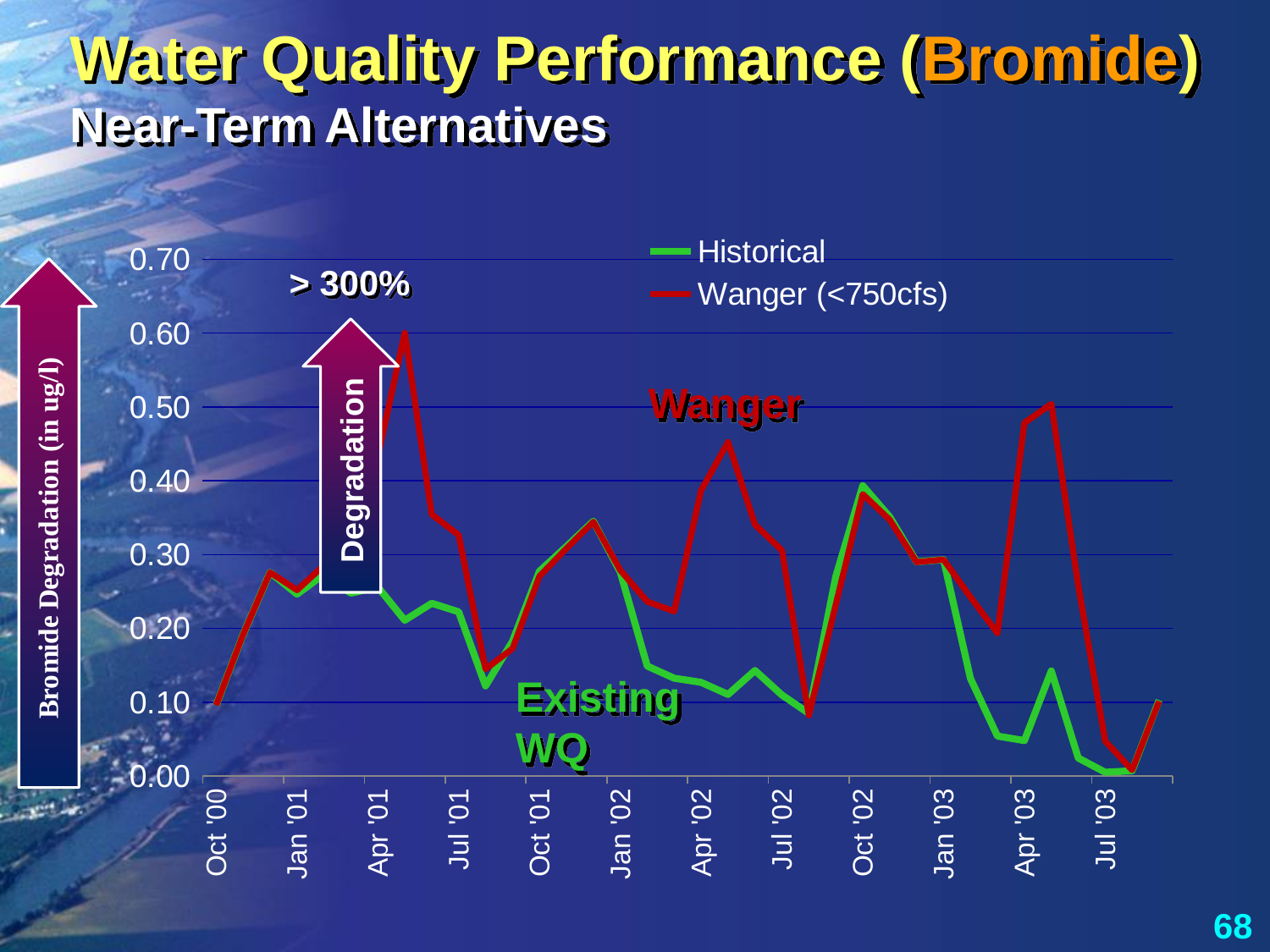
How many labelled tick marks are on the x axis? 12 Is the peak value of the Wanger (<750cfs) series around Apr '01 greater or less than 0.50? greater Does the Historical series rise or fall between Oct '02 and Jul '03? fall Which series reaches the highest value on the chart? Wanger (<750cfs) At Apr '02, which series has the larger value, Historical or Wanger (<750cfs)? Wanger (<750cfs) Does the Wanger (<750cfs) series rise or fall between Oct '00 and Apr '01? rise Is the Historical value at Jul '03 greater or less than 0.10? less Is the Historical value at Oct '02 greater or less than 0.30? greater How many series does the legend list? 2 What kind of chart is shown on the slide? line chart What is the label on the vertical axis? Bromide Degradation (in ug/l) What are the two series named in the legend? Historical and Wanger (<750cfs)